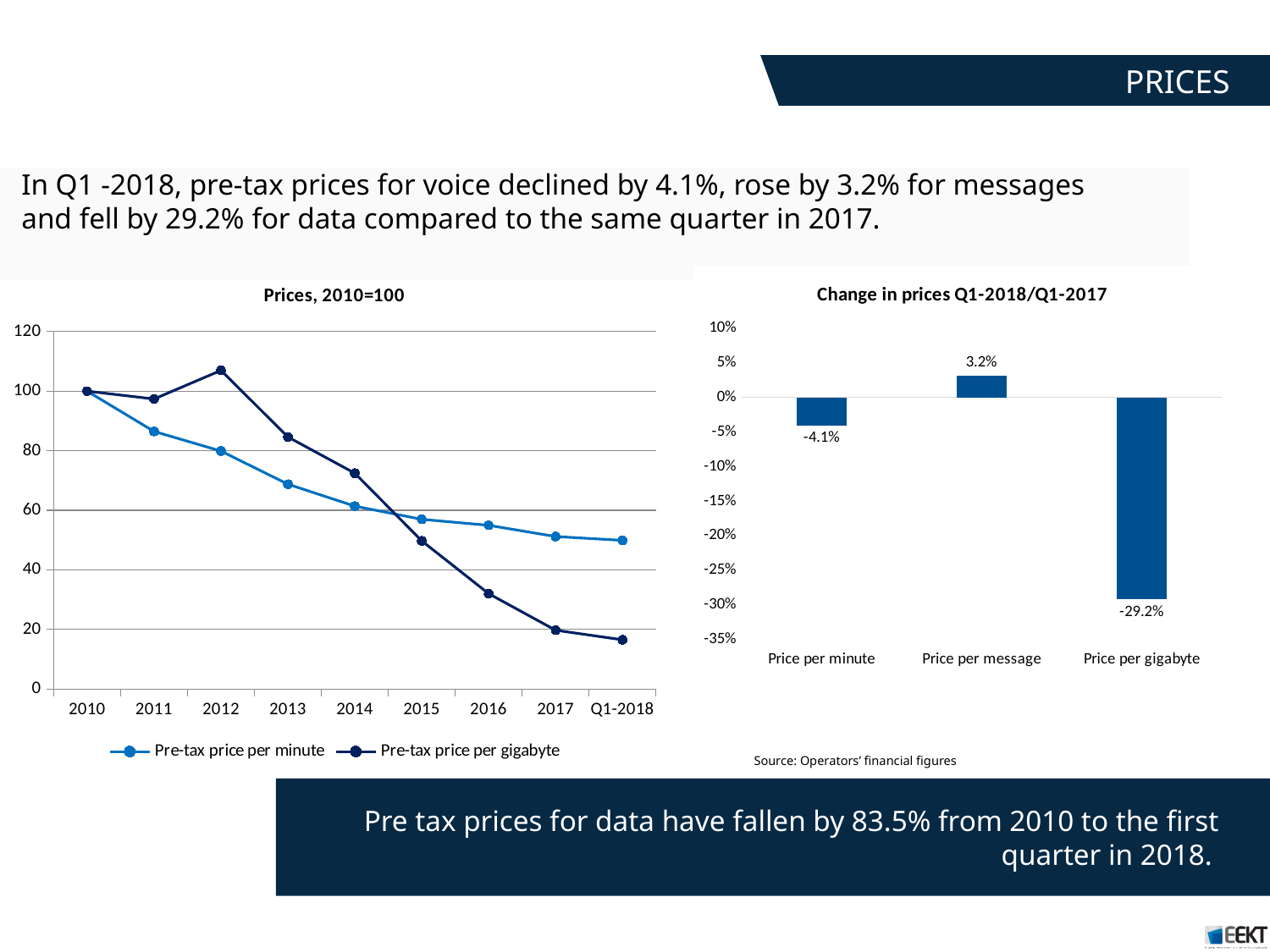
In the 'Change in prices Q1-2018/Q1-2017' chart, how many categories are shown? 3 In the 'Change in prices Q1-2018/Q1-2017' chart, what is the value for Price per minute? -4.1% In the 'Prices, 2010=100' chart, does the Pre-tax price per minute series rise or fall from 2010 to Q1-2018? Fall In the 'Change in prices Q1-2018/Q1-2017' chart, what is the difference in percentage points between Price per message and Price per minute? 7.3 percentage points In the 'Change in prices Q1-2018/Q1-2017' chart, which category has the highest value? Price per message In the 'Change in prices Q1-2018/Q1-2017' chart, what is the value for Price per message? 3.2% In the 'Prices, 2010=100' chart, is the value for Pre-tax price per gigabyte in Q1-2018 greater or less than 20? less In the 'Change in prices Q1-2018/Q1-2017' chart, what is the value for Price per gigabyte? -29.2% How many series does the legend of the 'Prices, 2010=100' chart list? 2 What kind of chart is the 'Prices, 2010=100' chart? Line chart In the 'Change in prices Q1-2018/Q1-2017' chart, which category has the lowest value? Price per gigabyte In the 'Prices, 2010=100' chart, how many points are plotted along the x axis for each series? 9